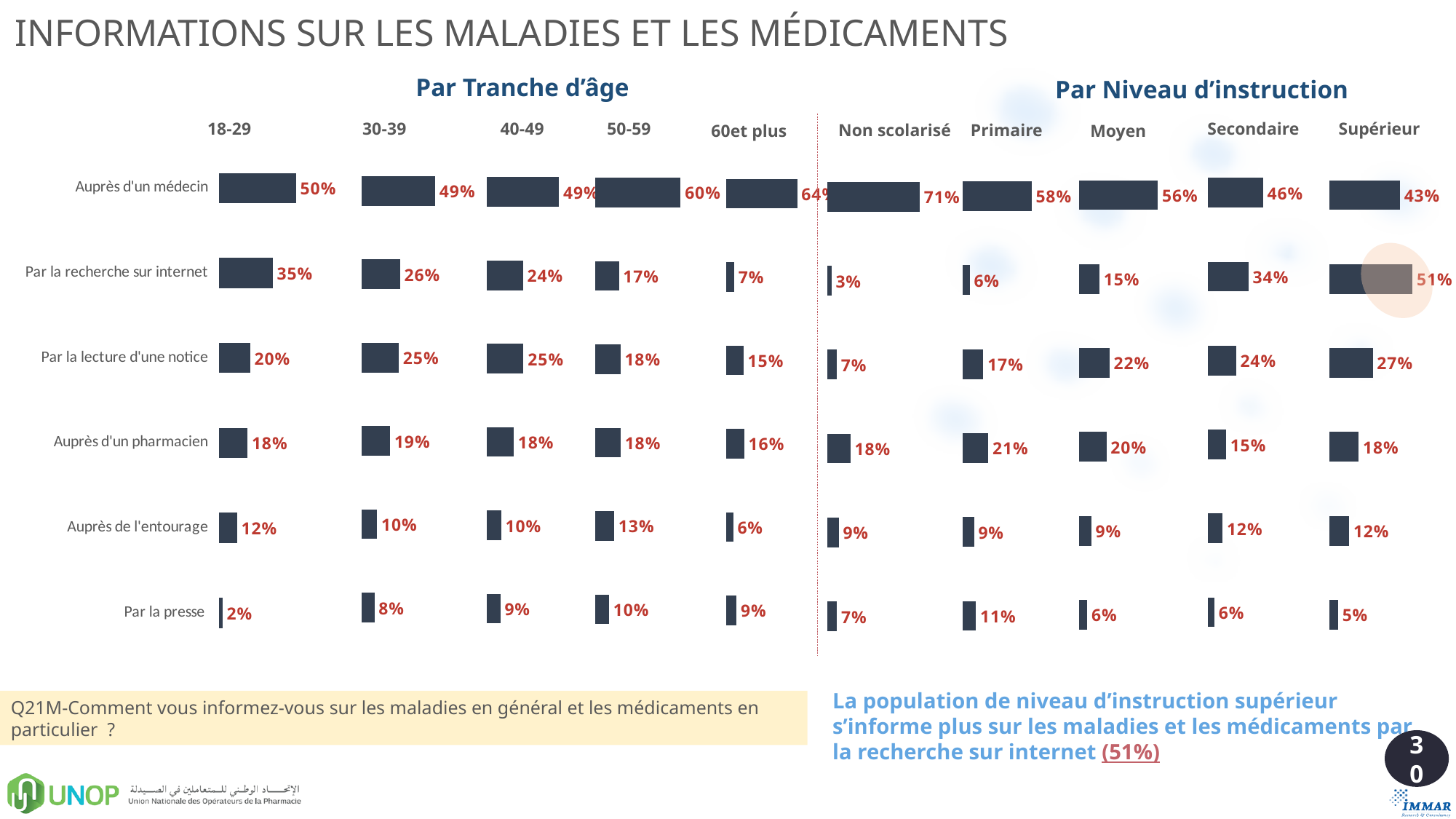
In the Primaire chart, which is larger: 'Auprès d'un pharmacien' or 'Par la lecture d'une notice'? Auprès d'un pharmacien In the 18-29 chart, which category has the lowest value? Par la presse How many categories does each chart on the slide show? 6 In the Supérieur chart, what is the value for 'Par la recherche sur internet'? 51% In the Non scolarisé chart, which category has the highest value? Auprès d'un médecin In the 18-29 chart, what is the value for 'Par la recherche sur internet'? 35% Across the education-level charts from Non scolarisé to Supérieur, does the value for 'Par la recherche sur internet' rise or fall? Rise In the 50-59 chart, what is the difference between 'Auprès d'un médecin' and 'Par la lecture d'une notice'? 42% In the Moyen chart, what is the value for 'Par la presse'? 6% In the 60et plus chart, what is the difference between 'Auprès d'un médecin' and 'Par la recherche sur internet'? 57% What kind of chart is used for the 'Par Tranche d'âge' section? Bar chart What is the title of the right-hand group of charts? Par Niveau d'instruction